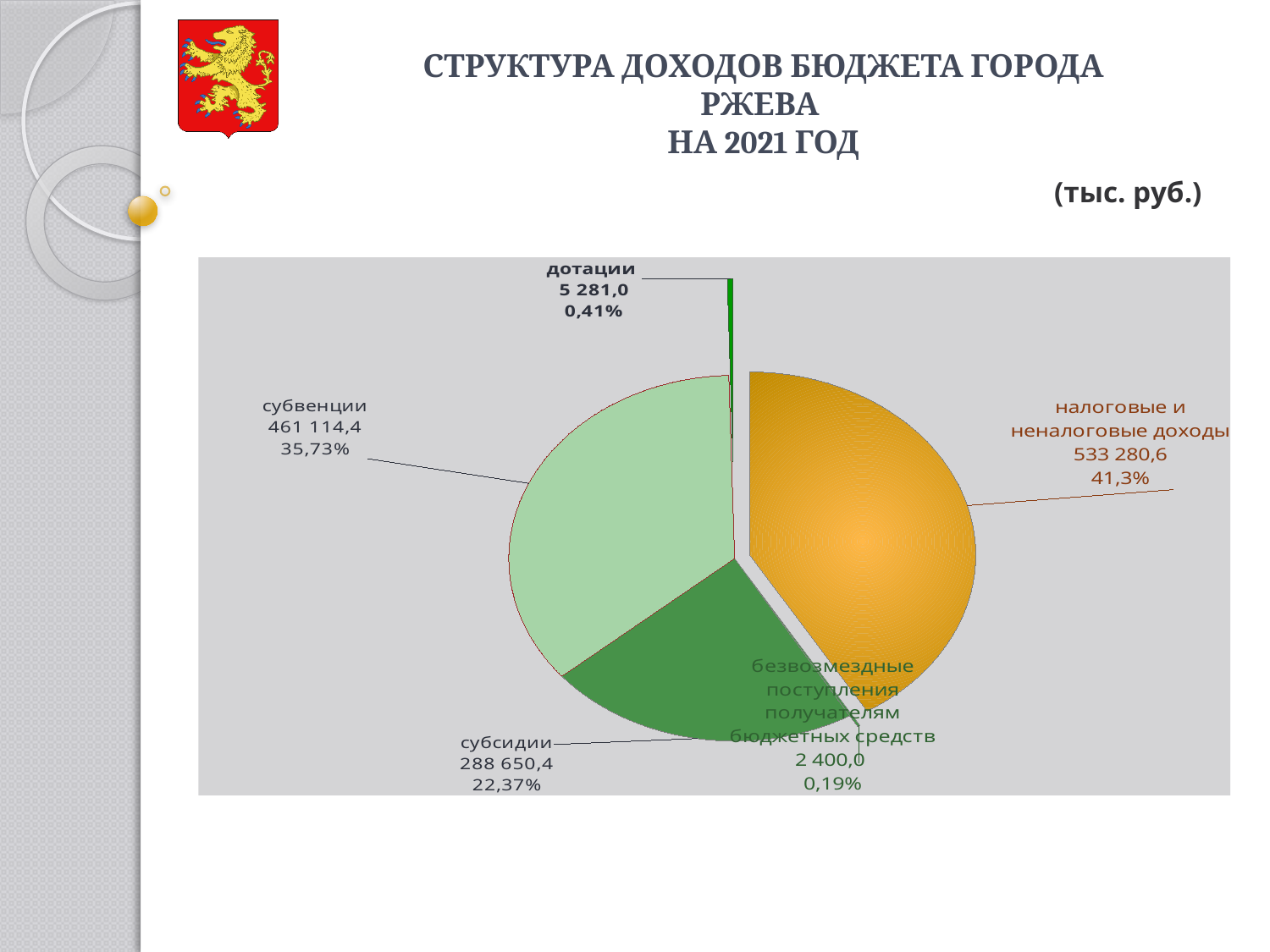
How many slices does the pie chart have? 5 What is the value for дотации? 5 281,0 What is the value for субсидии? 288 650,4 What share of the pie does субсидии represent? 22,37% Which is larger, the value for субвенции or the value for субсидии? субвенции What is the value for налоговые и неналоговые доходы? 533 280,6 What is the value for субвенции? 461 114,4 Which category has the largest value? налоговые и неналоговые доходы What kind of chart is shown on the slide? pie chart What share of the pie does безвозмездные поступления получателям бюджетных средств represent? 0,19% What is the difference between the values for налоговые и неналоговые доходы and субвенции? 72 166,2 Which category has the smallest value? безвозмездные поступления получателям бюджетных средств